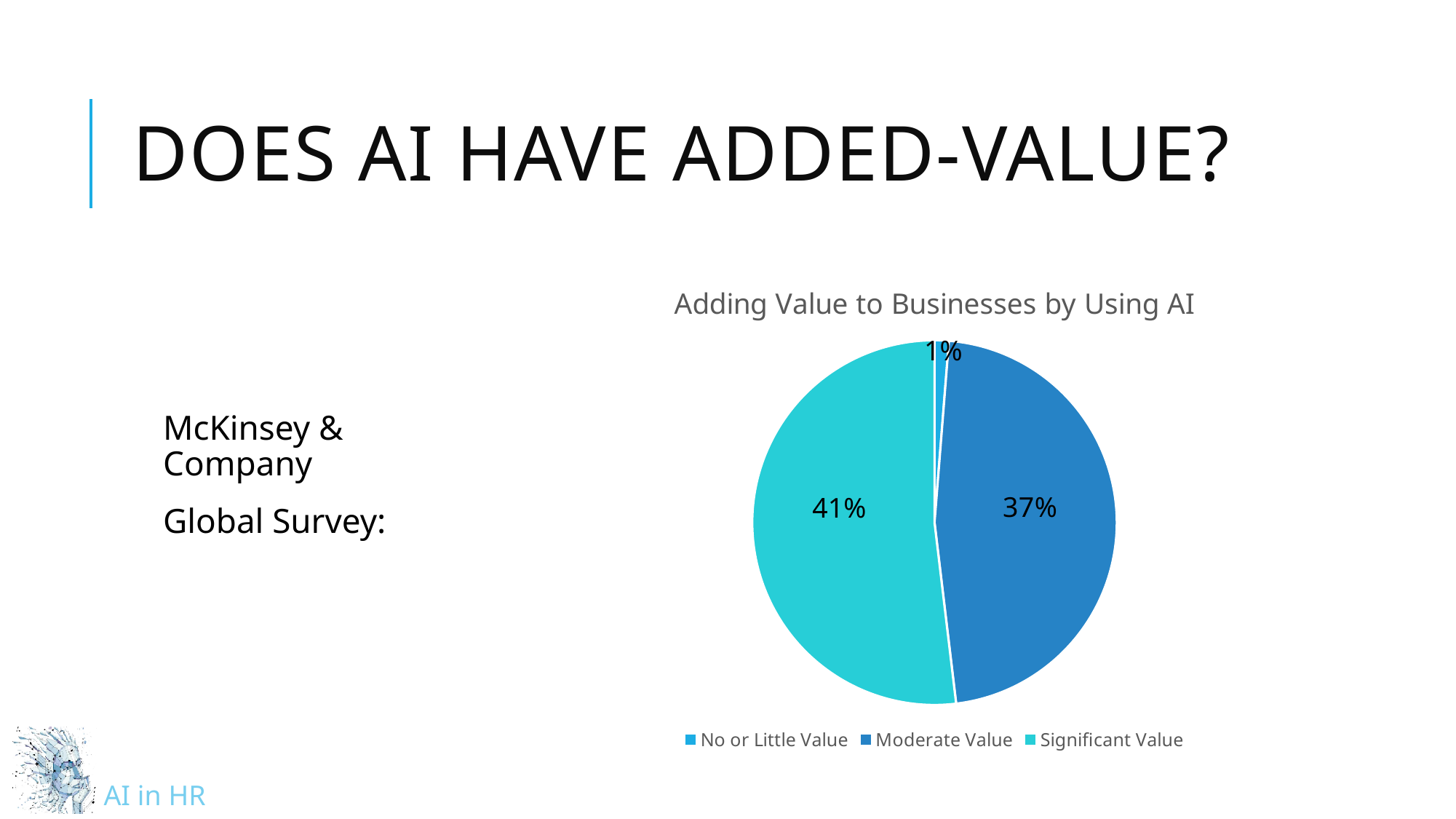
Which legend entry is shown in the lightest turquoise colour? Significant Value What is the difference in percentage points between Significant Value and Moderate Value? 4 How many categories does the legend list? 3 What percentage of the pie is labelled for Moderate Value? 37% What percentage of the pie is labelled for No or Little Value? 1% What kind of chart is shown on the slide? pie chart Which category has the smallest slice of the pie? No or Little Value What is the difference in percentage points between Moderate Value and No or Little Value? 36 Which category has the largest slice of the pie? Significant Value Which is larger, the slice for Moderate Value or the slice for No or Little Value? Moderate Value What percentage of the pie is labelled for Significant Value? 41% What is the title of the chart? Adding Value to Businesses by Using AI